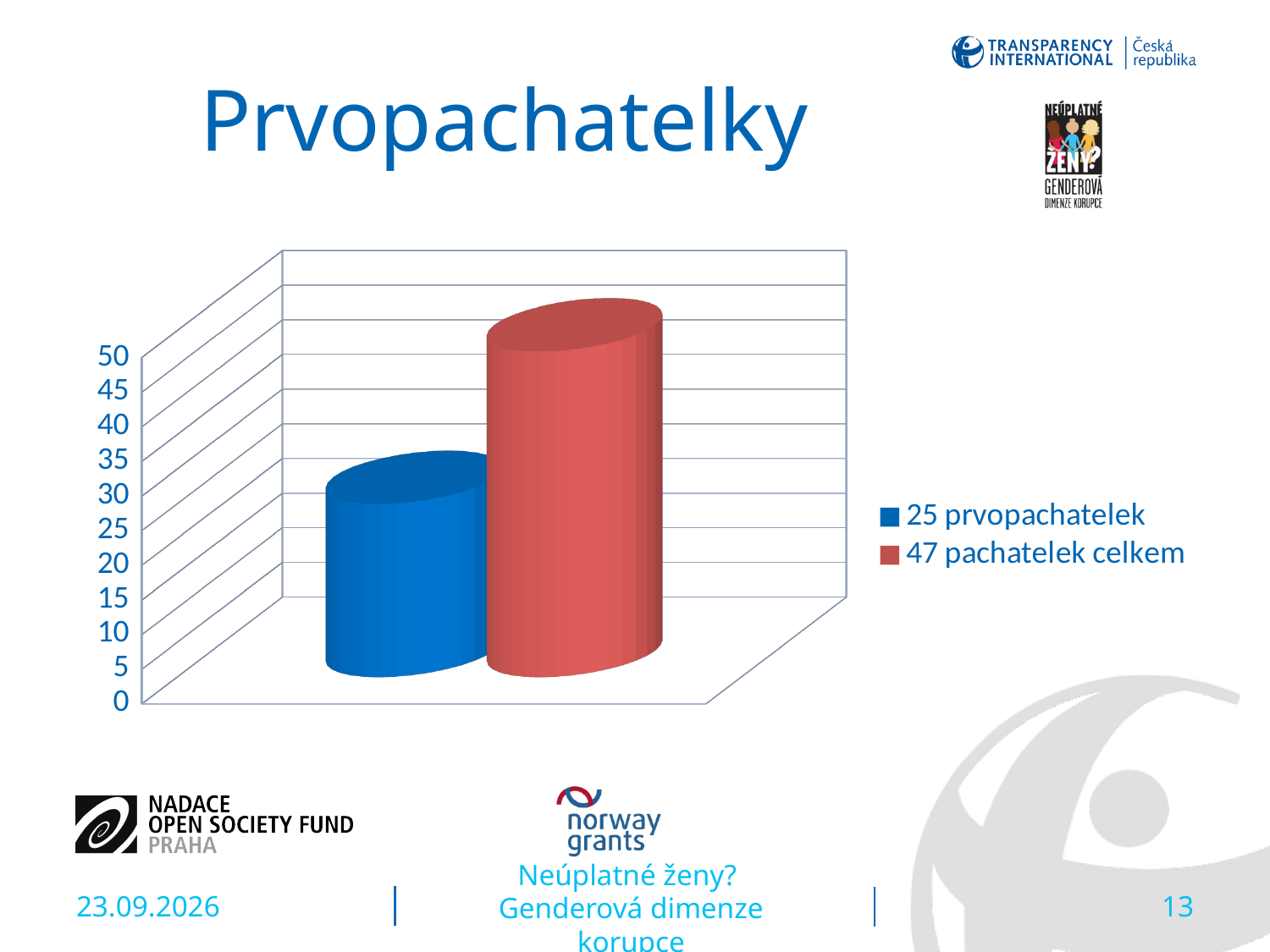
How many bars are plotted in the chart? 2 What colour is used for the '25 prvopachatelek' series? blue Which series has the highest value? 47 pachatelek celkem What is the title of the slide above the chart? Prvopachatelky What value does the legend give for the blue series (prvopachatelek)? 25 Which series has the lowest value? 25 prvopachatelek Is the value of the red bar (pachatelek celkem) greater or less than 20? greater Which bar is taller, the blue one (prvopachatelek) or the red one (pachatelek celkem)? the red one (pachatelek celkem) What kind of chart is shown on the slide? bar chart What is the difference between the total number of offenders (47) and the number of first-time offenders (25)? 22 How many series does the chart legend list? 2 What value does the legend give for the red series (pachatelek celkem)? 47